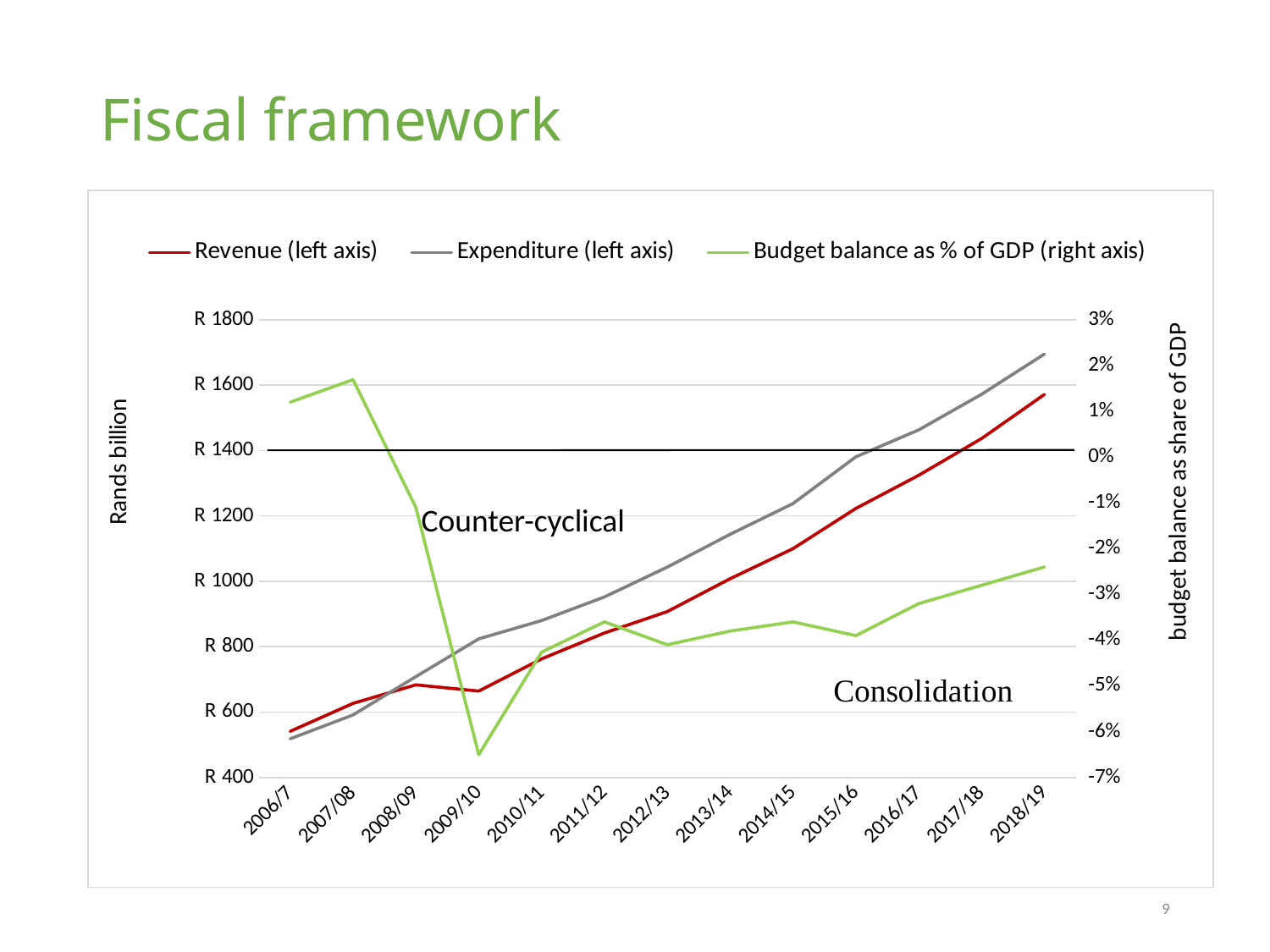
In which year is the Budget balance as % of GDP at its lowest? 2009/10 In which year is Revenue at its highest? 2018/19 What kind of chart is shown on the slide? line chart Does Expenditure rise or fall from 2006/7 to 2018/19? rise Is the value for Revenue in 2006/7 greater or less than R 600? less How many fiscal years are shown on the x axis? 13 What is the label on the left vertical axis? Rands billion Is the value for Budget balance as % of GDP in 2009/10 greater or less than -6%? less How many series does the legend list? 3 In which year is the Budget balance as % of GDP at its highest? 2007/08 Which is larger in 2018/19, Revenue or Expenditure? Expenditure Is the value for Expenditure in 2018/19 greater or less than R 1600? greater